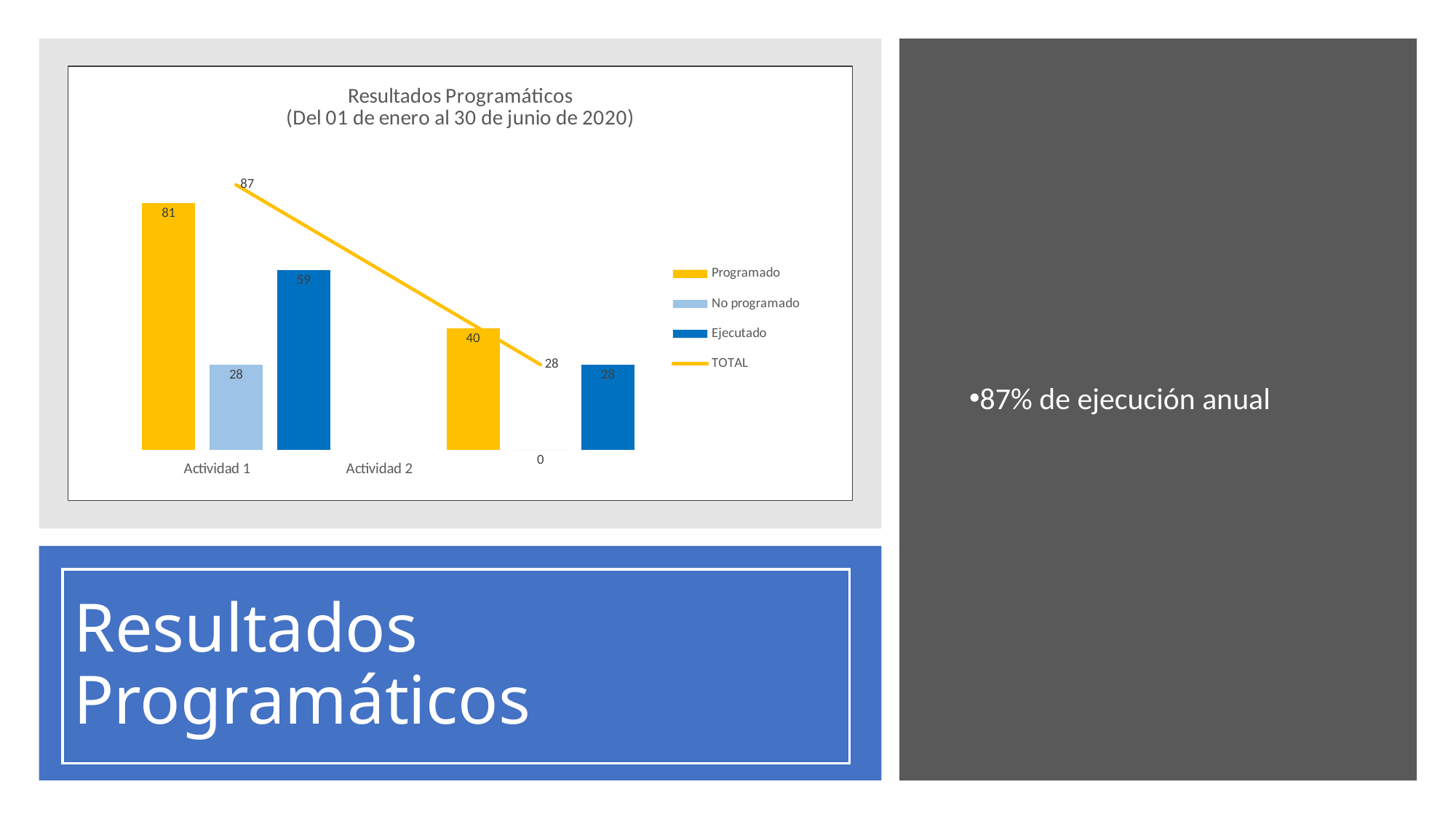
Is the Ejecutado value for Actividad 1 larger or smaller than the Programado value for Actividad 2? larger Does the TOTAL line rise or fall from Actividad 1 to Actividad 2? fall What is the Programado value for Actividad 1? 81 How many activities are shown on the x axis? 2 Which activity has the higher Programado value? Actividad 1 What is the Ejecutado value for Actividad 2? 28 What is the TOTAL value for Actividad 1? 87 What is the No programado value for Actividad 1? 28 What is the difference between the Programado and Ejecutado values for Actividad 1? 22 How many series does the legend list? 4 What is the title of the chart? Resultados Programáticos (Del 01 de enero al 30 de junio de 2020) What is the difference between the Programado values for Actividad 1 and Actividad 2? 41